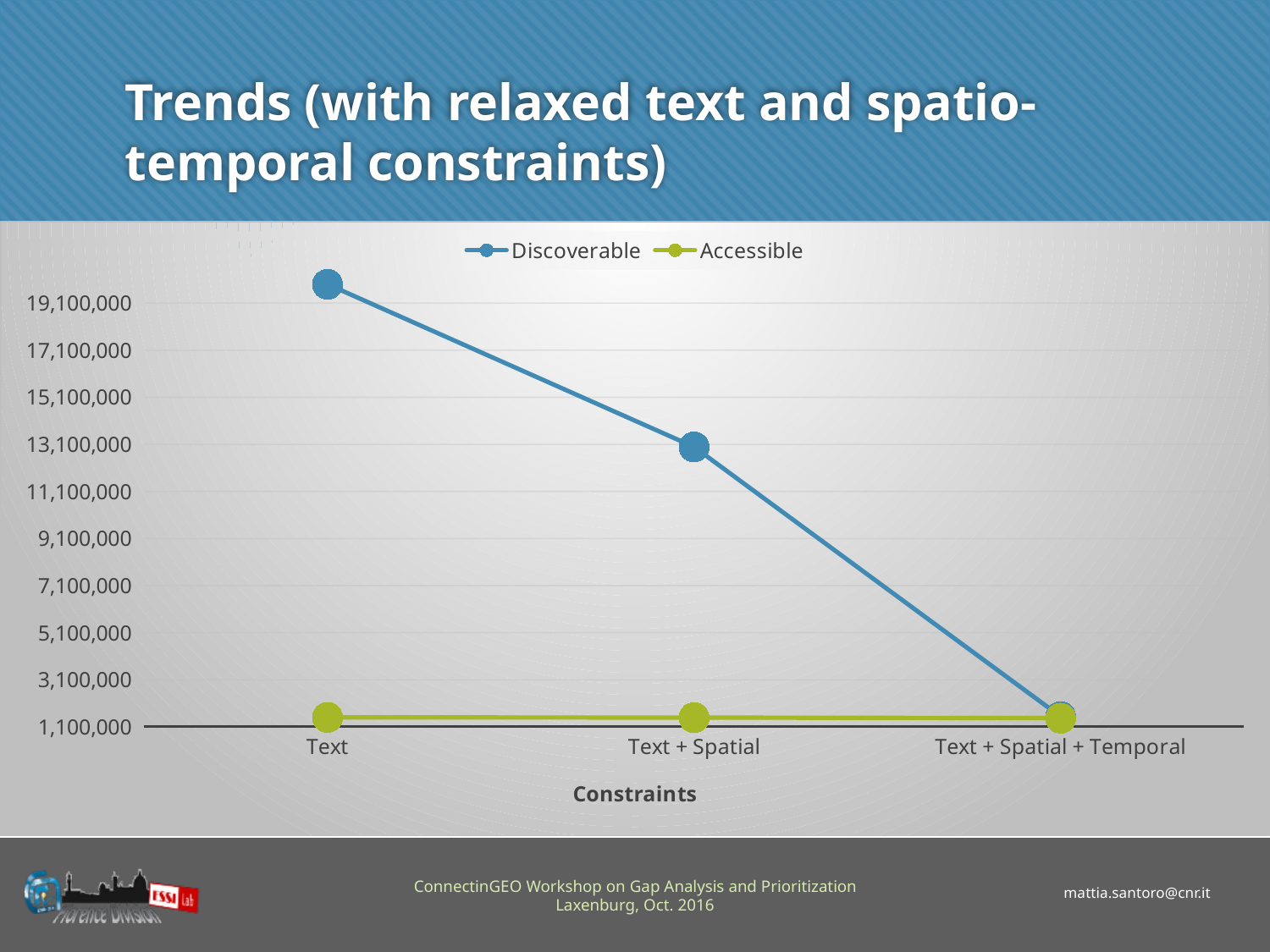
Which category has the highest Discoverable value? Text Is the Discoverable value for Text greater or less than 17,100,000? greater How many categories are shown on the x axis? 3 Do the Discoverable values rise or fall from Text to Text + Spatial + Temporal? fall What is the title of the x axis? Constraints For the Text category, which series has the larger value, Discoverable or Accessible? Discoverable Is the Discoverable value for Text + Spatial greater or less than 11,100,000? greater Is the Discoverable value for Text + Spatial + Temporal greater or less than 3,100,000? less What kind of chart is shown on the slide? line chart How many series does the legend list? 2 Which category has the lowest Discoverable value? Text + Spatial + Temporal